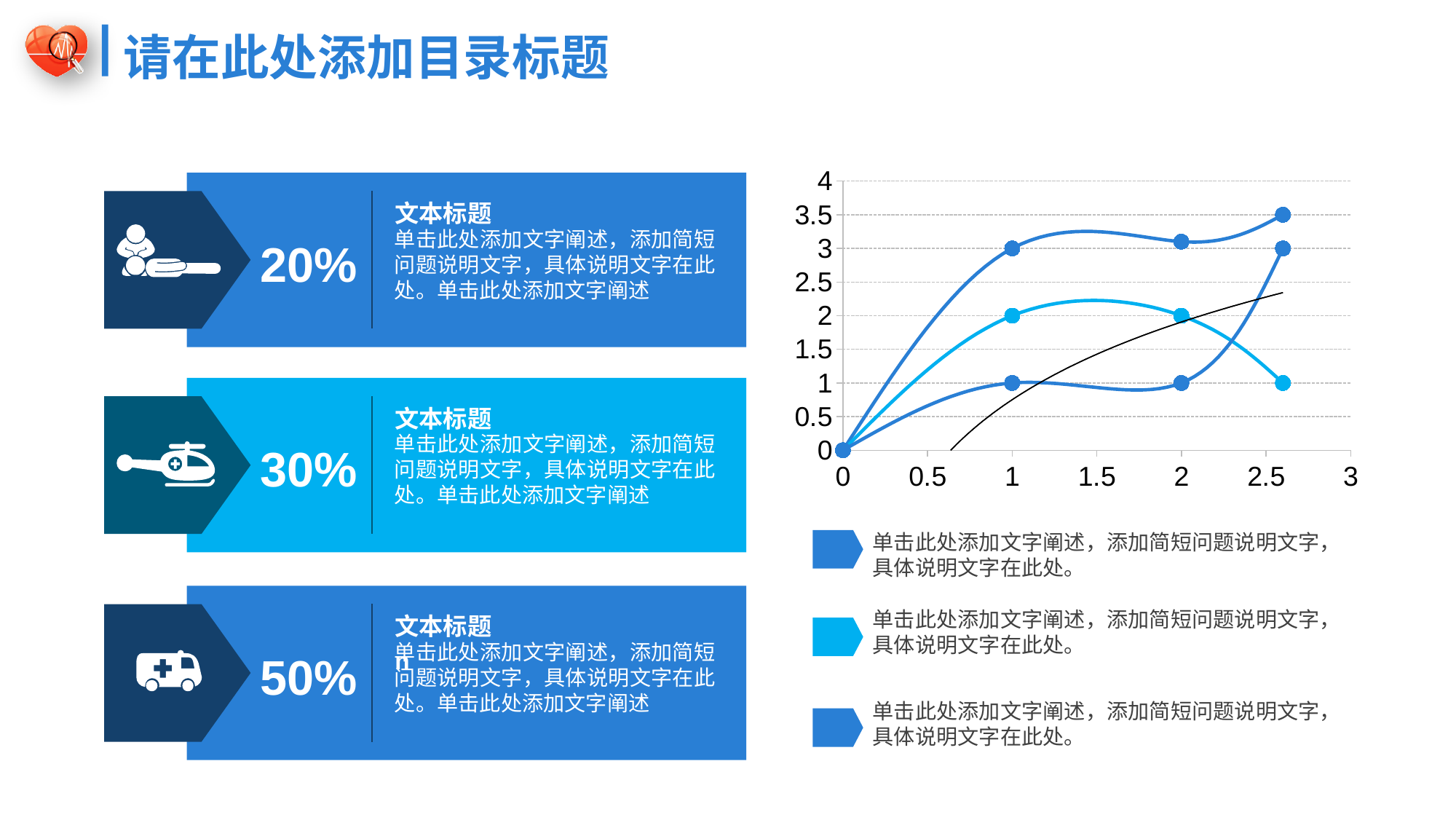
What is the y value of the uppermost dark blue line at x = 1? 3 What is the y value of the light blue line at x = 1? 2 At x = 2, which is larger: the light blue line's value or the lowest dark blue line's value? the light blue line How many coloured data lines are plotted on the chart? 3 Does the light blue line rise or fall between x = 2 and its last point? fall What is the highest y value reached by any plotted point on the chart? 3.5 What kind of chart is shown on the right of the slide? line chart What is the y value of the lowest line at x = 1? 1 What is the y value of the light blue line at x = 2? 2 What is the y value of the rightmost point of the light blue line? 1 At x = 1, what is the difference between the uppermost line's value and the light blue line's value? 1 What is the highest tick value shown on the y axis? 4